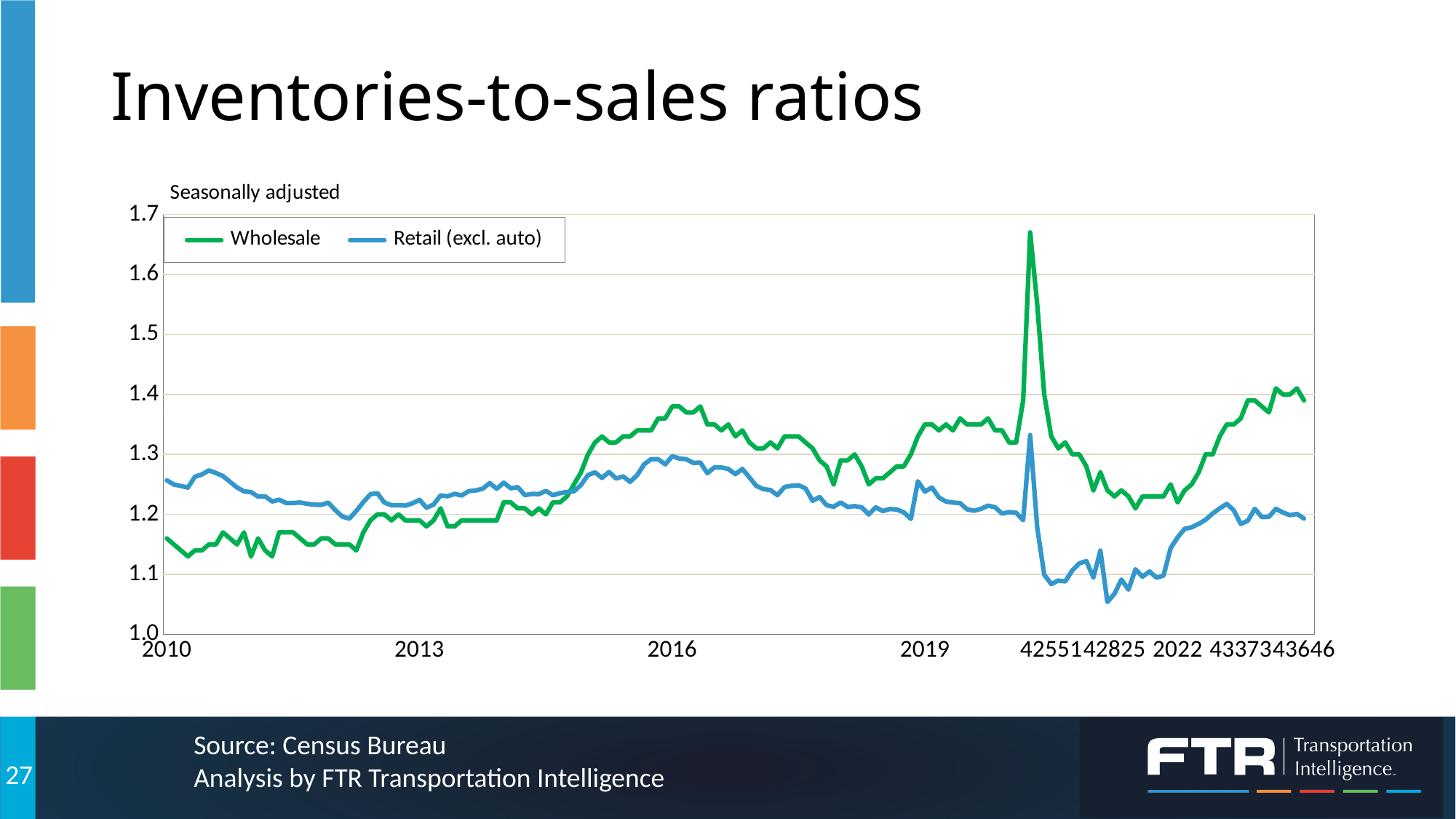
What kind of chart is shown on the slide? Line chart How many series does the legend list? 2 Does the Wholesale line generally rise or fall between 2010 and 2016? Rise At the start of 2010, which series has the higher value, Wholesale or Retail (excl. auto)? Retail (excl. auto) At the right end of the chart, which series has the higher value, Wholesale or Retail (excl. auto)? Wholesale Is the Wholesale value at the start of 2010 greater or less than 1.2? less What colour is the Wholesale line in the chart? Green Is the peak value of the Wholesale line greater or less than 1.6? greater Is the lowest value of the Retail (excl. auto) line greater or less than 1.1? less Which series reaches the highest value anywhere on the chart? Wholesale What is the title of the chart on the slide? Seasonally adjusted